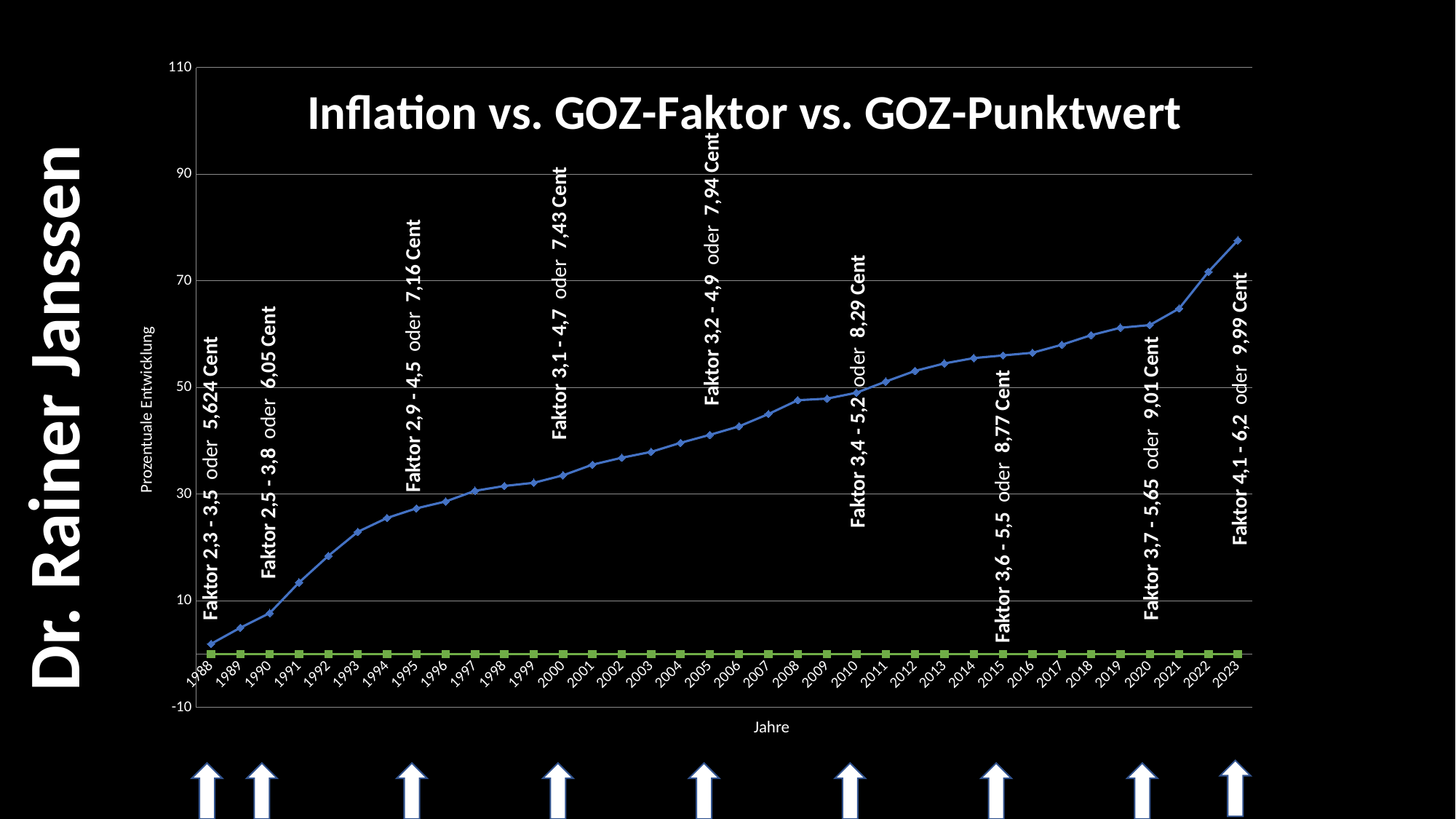
Is the value of the blue line for 1988 greater or less than 10? less Is the value of the blue line for 2021 greater or less than 70? less Is the value of the blue line for 2000 greater or less than 30? greater What kind of chart is shown on the slide? line chart In which year does the blue line have its lowest value? 1988 In which year does the blue line reach its highest value? 2023 What is the title of the chart? Inflation vs. GOZ-Faktor vs. GOZ-Punktwert Which is larger on the blue line, the value for 2005 or the value for 1995? 2005 Does the blue line rise or fall from 1988 to 2023? rise What is the label of the x axis? Jahre How many years are plotted along the x axis? 36